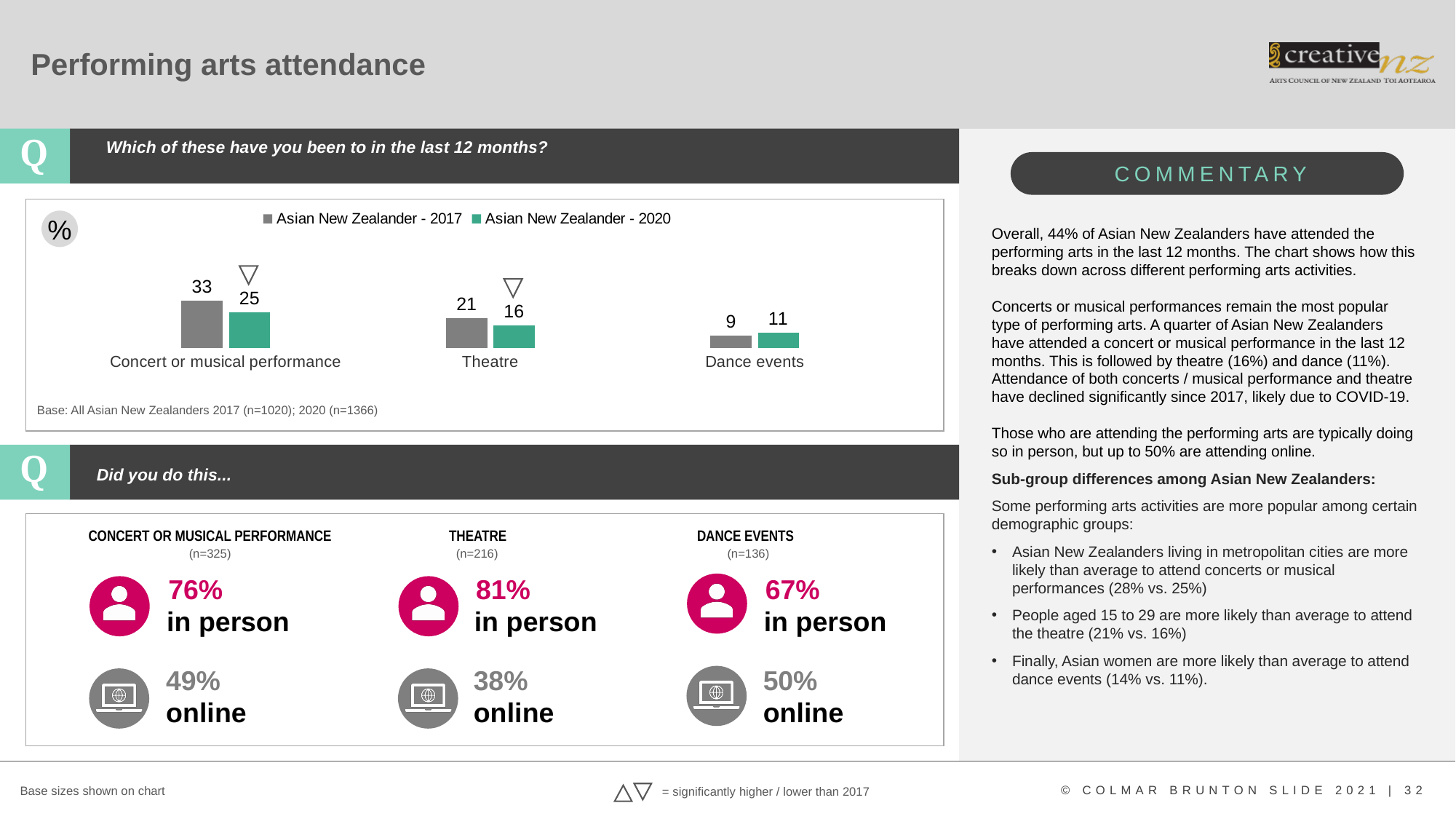
How many categories are shown on the x axis of the chart? 3 Do the Asian New Zealander - 2020 values rise or fall from Concert or musical performance to Dance events? Fall What is the value for Asian New Zealander - 2017 for Concert or musical performance? 33 What is the difference between the 2017 and 2020 values for Concert or musical performance? 8 Which category has the lowest value for Asian New Zealander - 2017? Dance events Which category has the highest value for Asian New Zealander - 2020? Concert or musical performance Which is larger for Dance events: the 2017 value or the 2020 value? 2020 What kind of chart is shown on the slide? Bar chart What is the value for Asian New Zealander - 2020 for Theatre? 16 How many series does the chart legend list? 2 What colour are the bars for Asian New Zealander - 2017? Grey What is the value for Asian New Zealander - 2020 for Dance events? 11